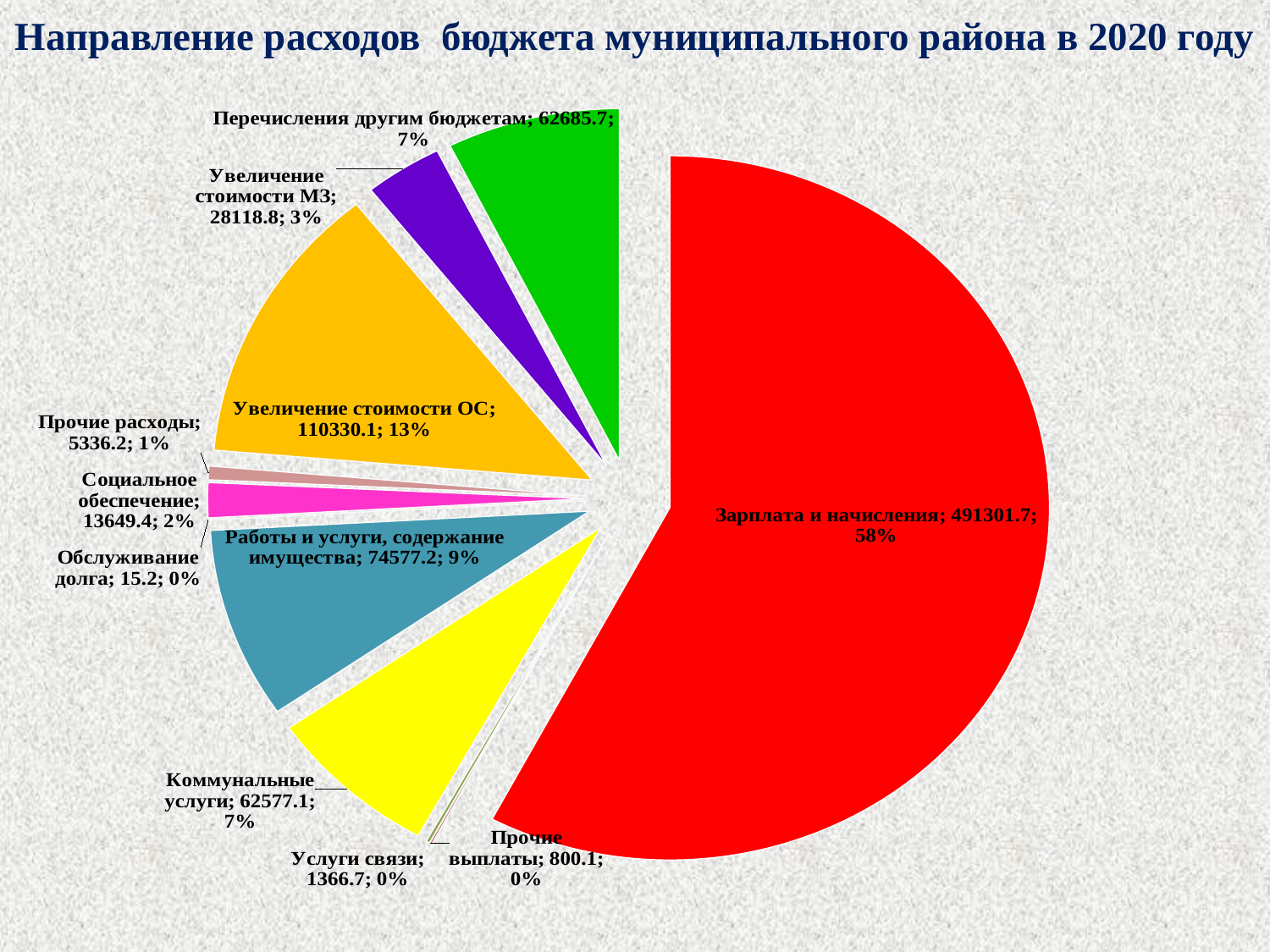
Which category has the smallest value? Обслуживание долга What type of chart is shown on the slide? pie chart What is the value for Увеличение стоимости ОС? 110330.1 What is the value for Коммунальные услуги? 62577.1 What is the title of the chart? Направление расходов бюджета муниципального района в 2020 году What share of the pie does Увеличение стоимости ОС represent? 13% What is the difference between the values for Увеличение стоимости ОС and Работы и услуги, содержание имущества? 35752.9 What share of the pie does Работы и услуги, содержание имущества represent? 9% Which category has the largest share of the pie? Зарплата и начисления Which is larger: the value for Коммунальные услуги or the value for Социальное обеспечение? Коммунальные услуги What is the value for Зарплата и начисления? 491301.7 How many categories (slices) does the pie chart have? 11